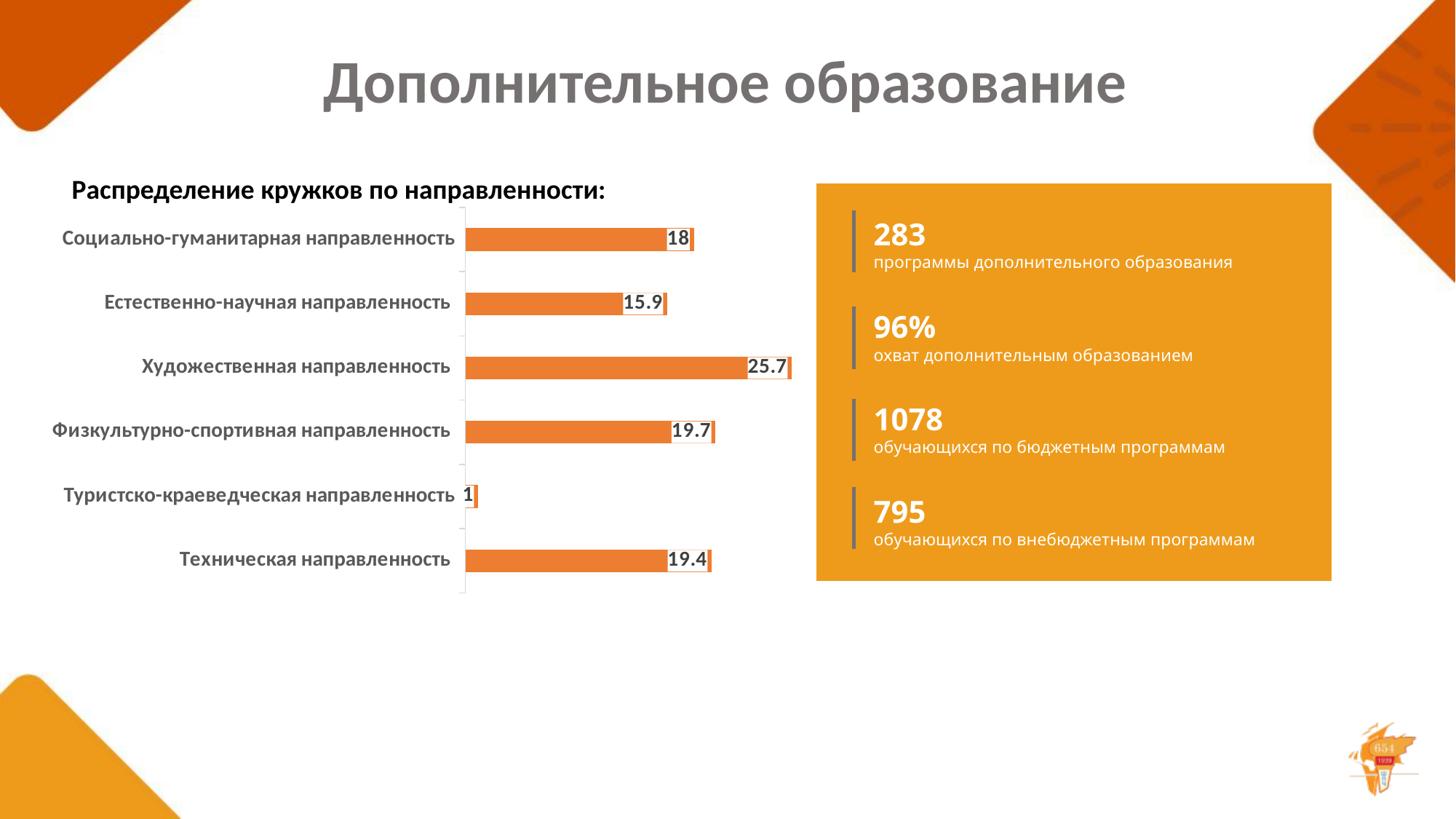
What is the difference between the values for Художественная направленность and Естественно-научная направленность? 9.8 What is the value for Туристско-краеведческая направленность? 1 Which category has the highest value? Художественная направленность What kind of chart is shown on the slide? Bar chart What is the value for Художественная направленность? 25.7 How many categories are shown in the chart? 6 What is the value for Естественно-научная направленность? 15.9 Which category has the lowest value? Туристско-краеведческая направленность What is the difference between the values for Физкультурно-спортивная направленность and Техническая направленность? 0.3 What is the title of the chart? Распределение кружков по направленности: What is the value for Социально-гуманитарная направленность? 18 Which is larger: the value for Социально-гуманитарная направленность or Естественно-научная направленность? Социально-гуманитарная направленность